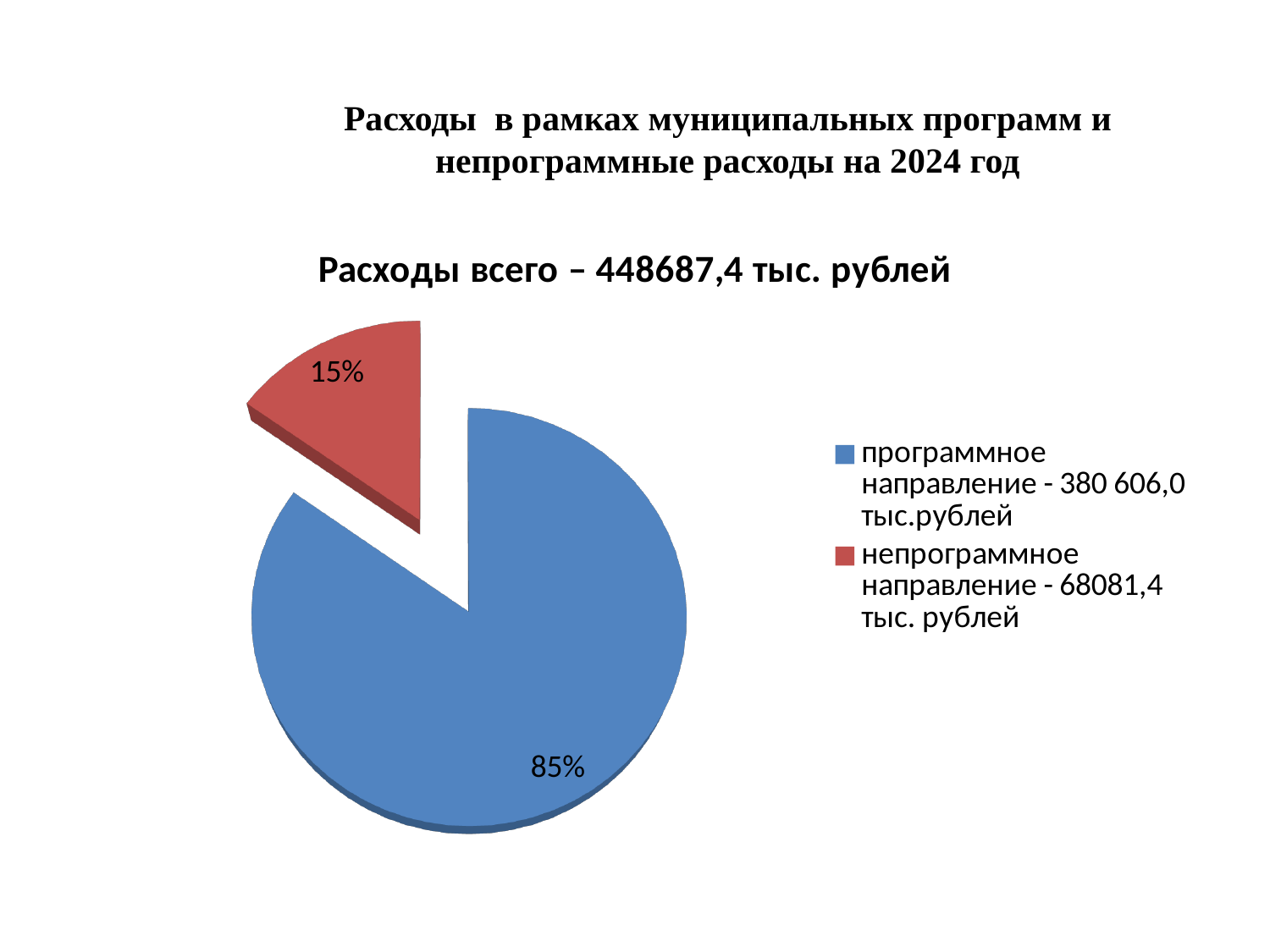
Which is larger: the share for 'программное направление' or for 'непрограммное направление'? программное направление What share of the pie does the 'программное направление' slice represent? 85% According to the legend, what amount in тыс. рублей corresponds to 'непрограммное направление'? 68081,4 What colour is the slice for 'непрограммное направление'? red According to the legend, what amount in тыс. рублей corresponds to 'программное направление'? 380 606,0 How many entries does the legend list? 2 Which slice of the pie is the largest? программное направление What share of the pie does the 'непрограммное направление' slice represent? 15% Which slice of the pie is the smallest? непрограммное направление What is the difference in percentage points between the 'программное направление' and 'непрограммное направление' shares? 70 What kind of chart is shown on the slide? pie chart How many slices does the pie chart have? 2